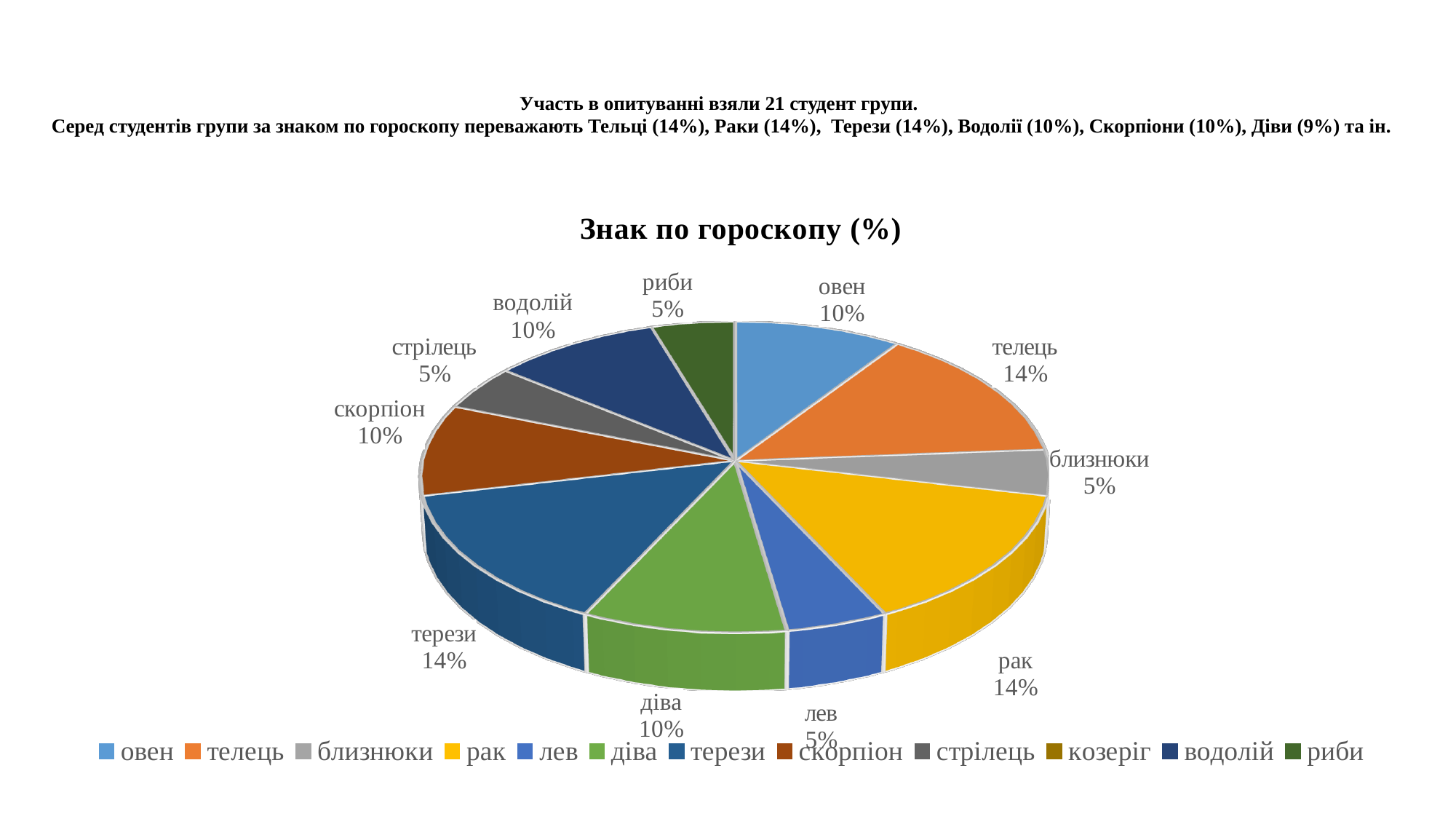
What percentage does the slice for риби show? 5% What kind of chart is shown on the slide? pie chart What percentage does the slice for близнюки show? 5% What percentage does the slice for терези show? 14% What percentage does the slice for овен show? 10% What is the chart's title? Знак по гороскопу (%) Which slice is larger, водолій or близнюки? водолій What percentage does the slice for телець show? 14% Which slice is larger, рак or лев? рак What percentage does the slice for скорпіон show? 10% What is the difference between the percentages for телець and стрілець? 9% How many entries does the legend list? 12